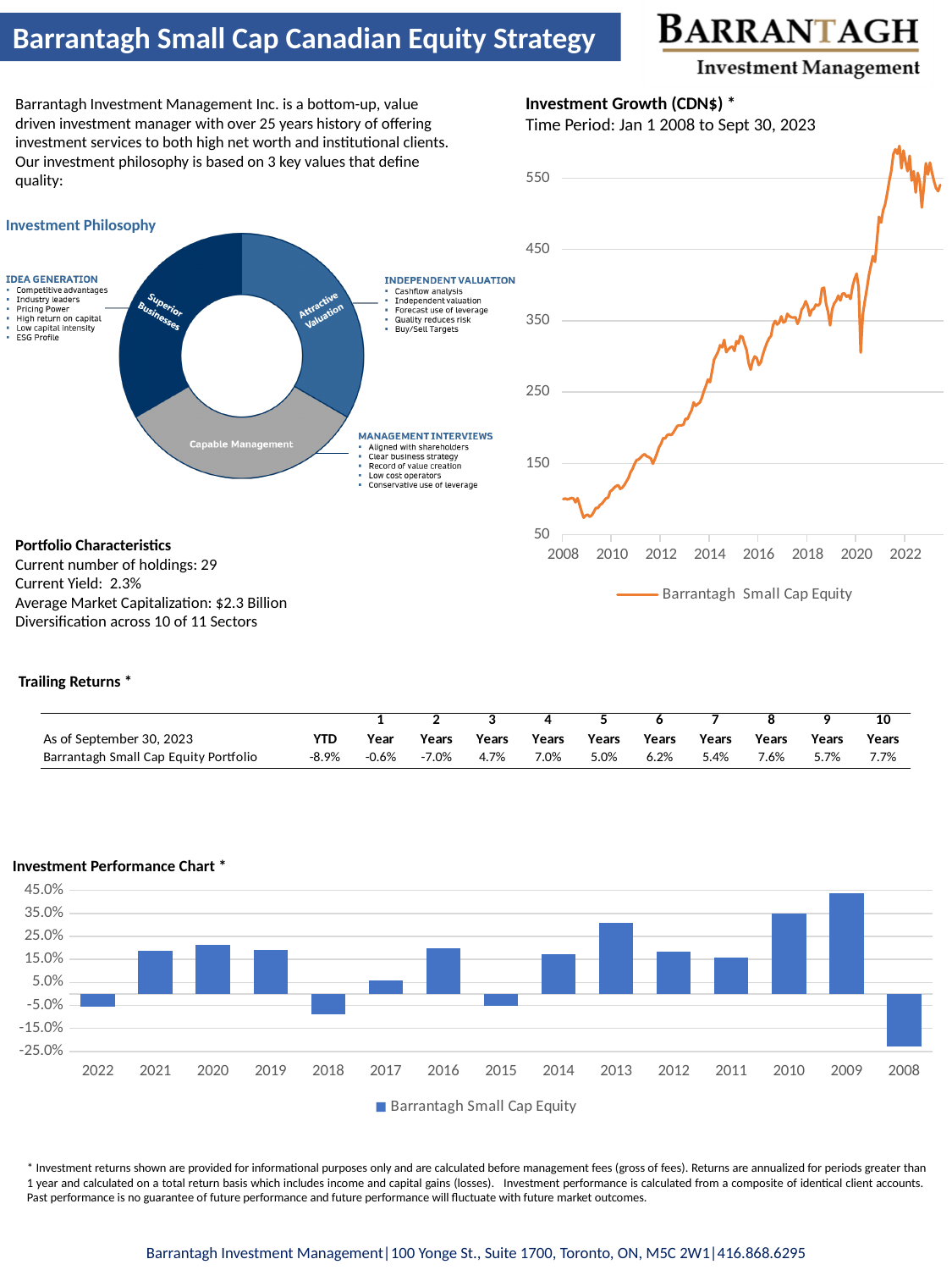
In the Investment Performance Chart, which year has the highest return? 2009 How many series does the legend of the Investment Growth (CDN$) chart list? 1 In the Investment Performance Chart, is the value for 2008 greater or less than -15.0%? less In the Investment Performance Chart, is the value for 2017 greater or less than 15.0%? less In the Investment Growth (CDN$) chart, does the line generally rise or fall from 2008 to 2022? rise In the Investment Performance Chart, is the value for 2013 greater or less than 25.0%? greater In the Investment Performance Chart, which year has the lowest return? 2008 How many years are shown on the x axis of the Investment Performance Chart? 15 What kind of chart is the Investment Performance Chart? bar chart What kind of chart is the Investment Growth (CDN$) chart? line chart In the Investment Performance Chart, which year has the larger return, 2010 or 2013? 2010